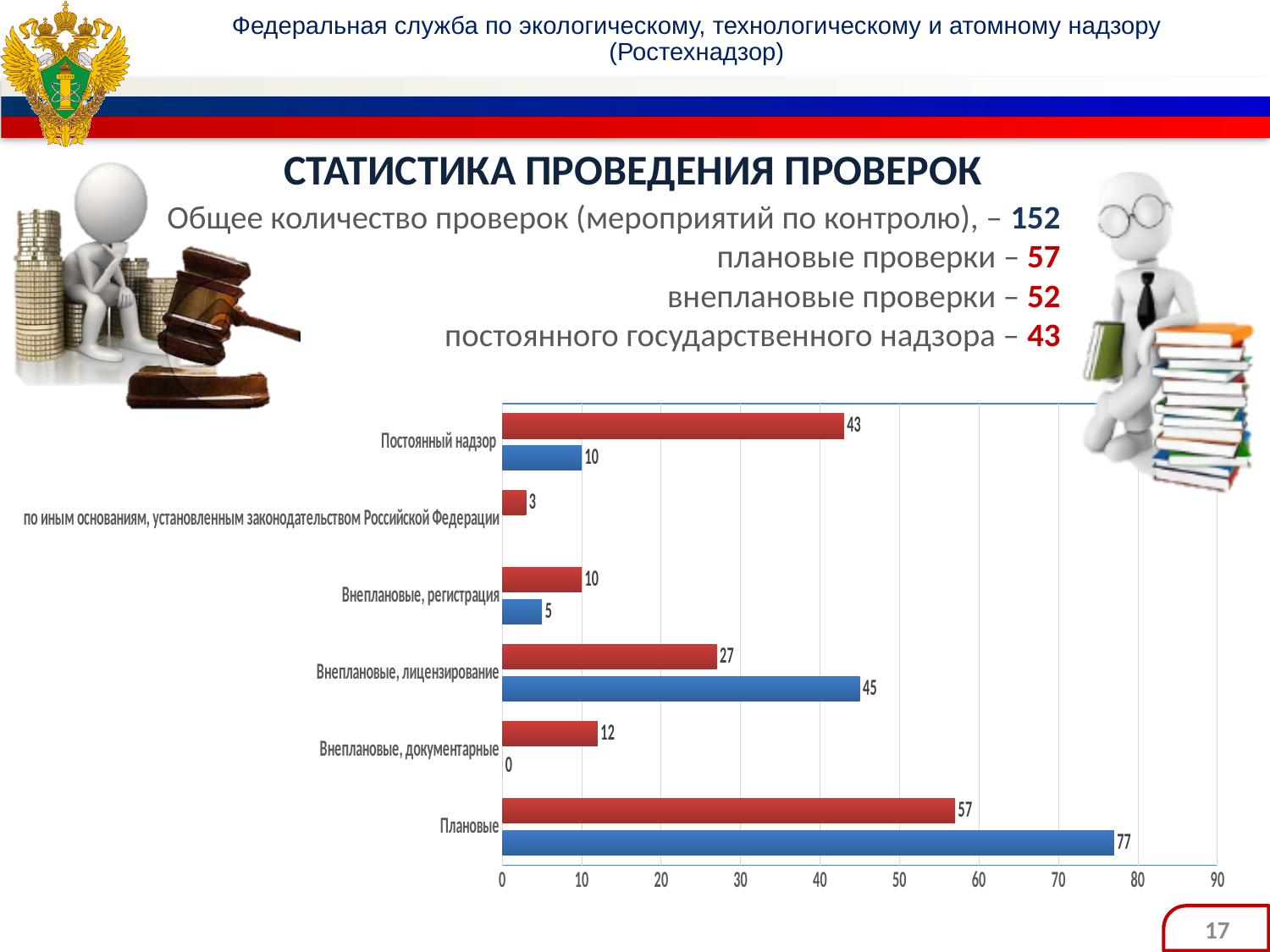
What kind of chart is shown on the slide? bar chart What is the difference between the blue and red bar values for "Плановые"? 20 Which category has the highest blue bar value? Плановые Which category has the lowest red bar value? по иным основаниям, установленным законодательством Российской Федерации How many categories are shown on the chart's vertical axis? 6 What is the value of the blue bar for "Внеплановые, лицензирование"? 45 For "Внеплановые, лицензирование", which is larger: the red bar or the blue bar? the blue bar What is the value of the blue bar for "Плановые"? 77 What is the value of the red bar for "Плановые"? 57 What is the maximum value shown on the chart's horizontal axis? 90 What is the value of the red bar for "по иным основаниям, установленным законодательством Российской Федерации"? 3 What is the value of the red bar for "Постоянный надзор"? 43